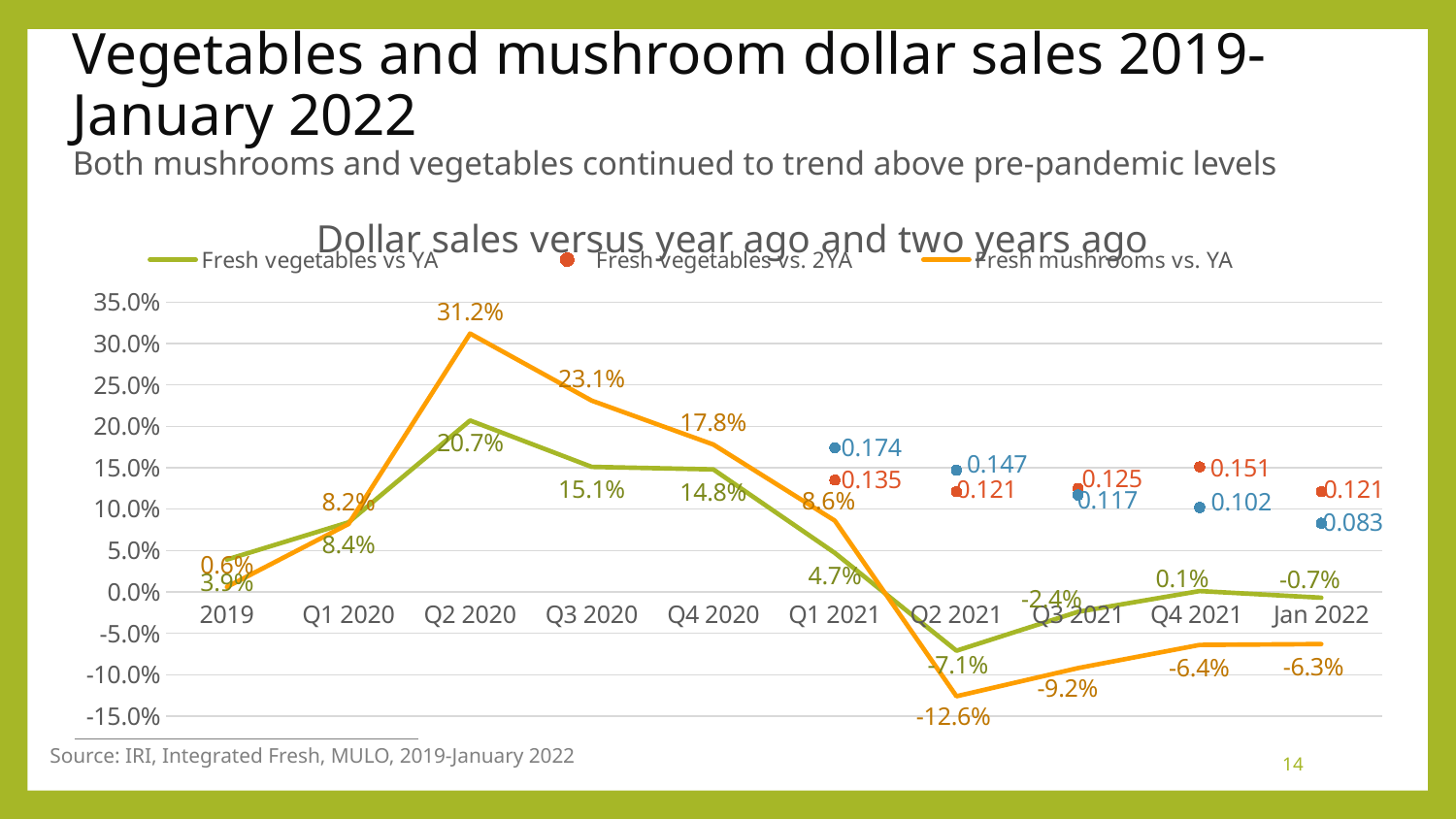
How many series does the legend list? 3 What is the difference between Fresh mushrooms vs. YA and Fresh vegetables vs YA in Q2 2020? 10.5 percentage points How many periods are shown on the x axis? 10 Does Fresh mushrooms vs. YA rise or fall from Q2 2020 to Q2 2021? Fall What kind of chart is this? Line chart In which period is Fresh vegetables vs YA lowest? Q2 2021 In Q4 2020, which is larger: Fresh mushrooms vs. YA or Fresh vegetables vs YA? Fresh mushrooms vs. YA What is the value for Fresh vegetables vs YA in Q2 2021? -7.1% What is the value for Fresh vegetables vs. 2YA in Q4 2021? 0.151 In which period is Fresh mushrooms vs. YA highest? Q2 2020 What is the value for Fresh mushrooms vs. YA in Jan 2022? -6.3% What is the value for Fresh mushrooms vs. YA in Q2 2020? 31.2%